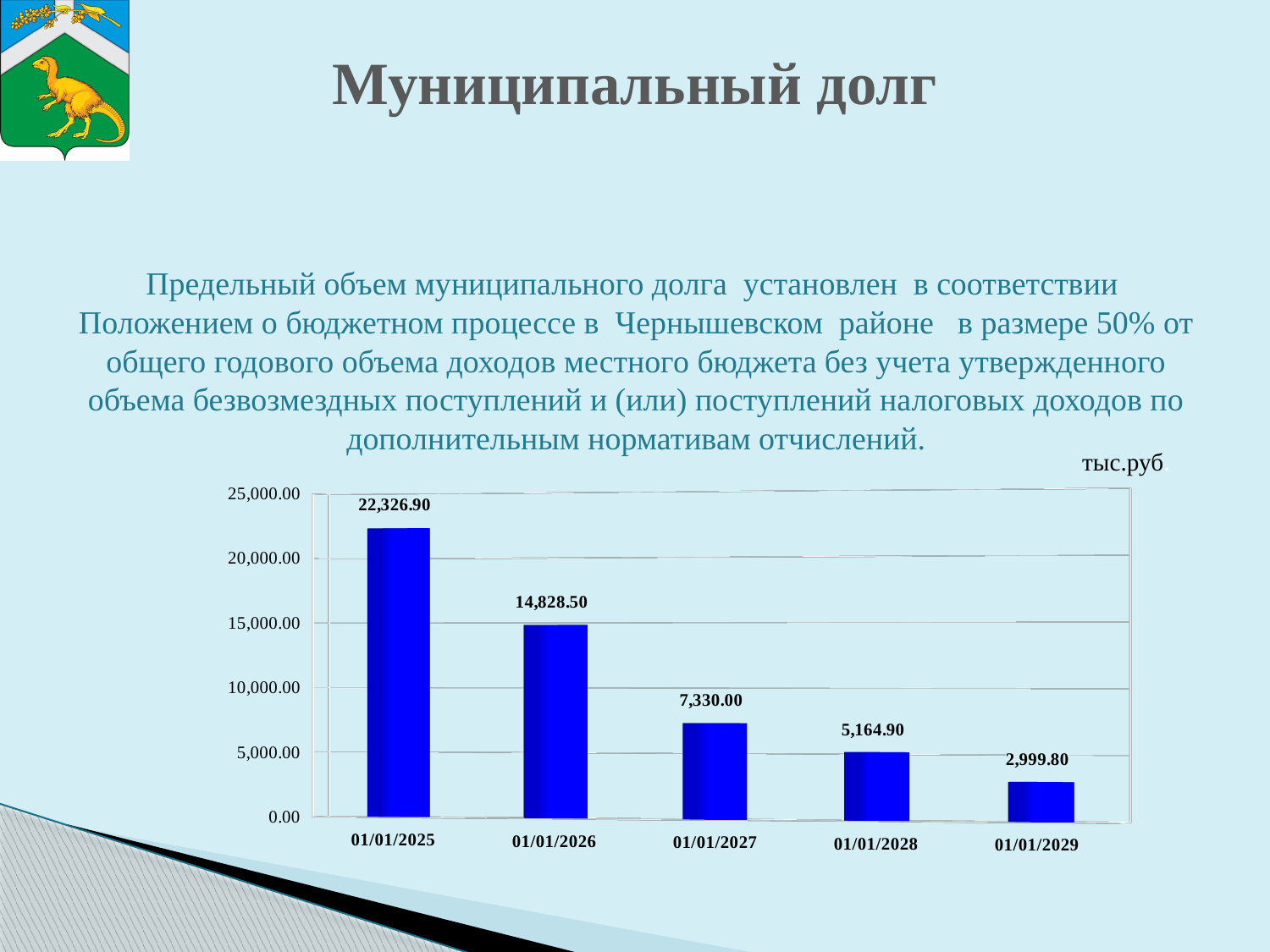
Which date has the lowest value? 01/01/2029 How many dates are shown on the x axis? 5 What is the difference between the values for 01/01/2028 and 01/01/2029? 2,165.10 What kind of chart is shown on the slide? bar chart What is the value for 01/01/2029? 2,999.80 Is the value for 01/01/2028 greater or less than 5,000.00? greater Which is larger, the value for 01/01/2026 or the value for 01/01/2027? 01/01/2026 What is the value for 01/01/2027? 7,330.00 Which date has the highest value? 01/01/2025 Do the values rise or fall from 01/01/2025 to 01/01/2029? fall What is the difference between the values for 01/01/2025 and 01/01/2026? 7,498.40 What is the value for 01/01/2025? 22,326.90